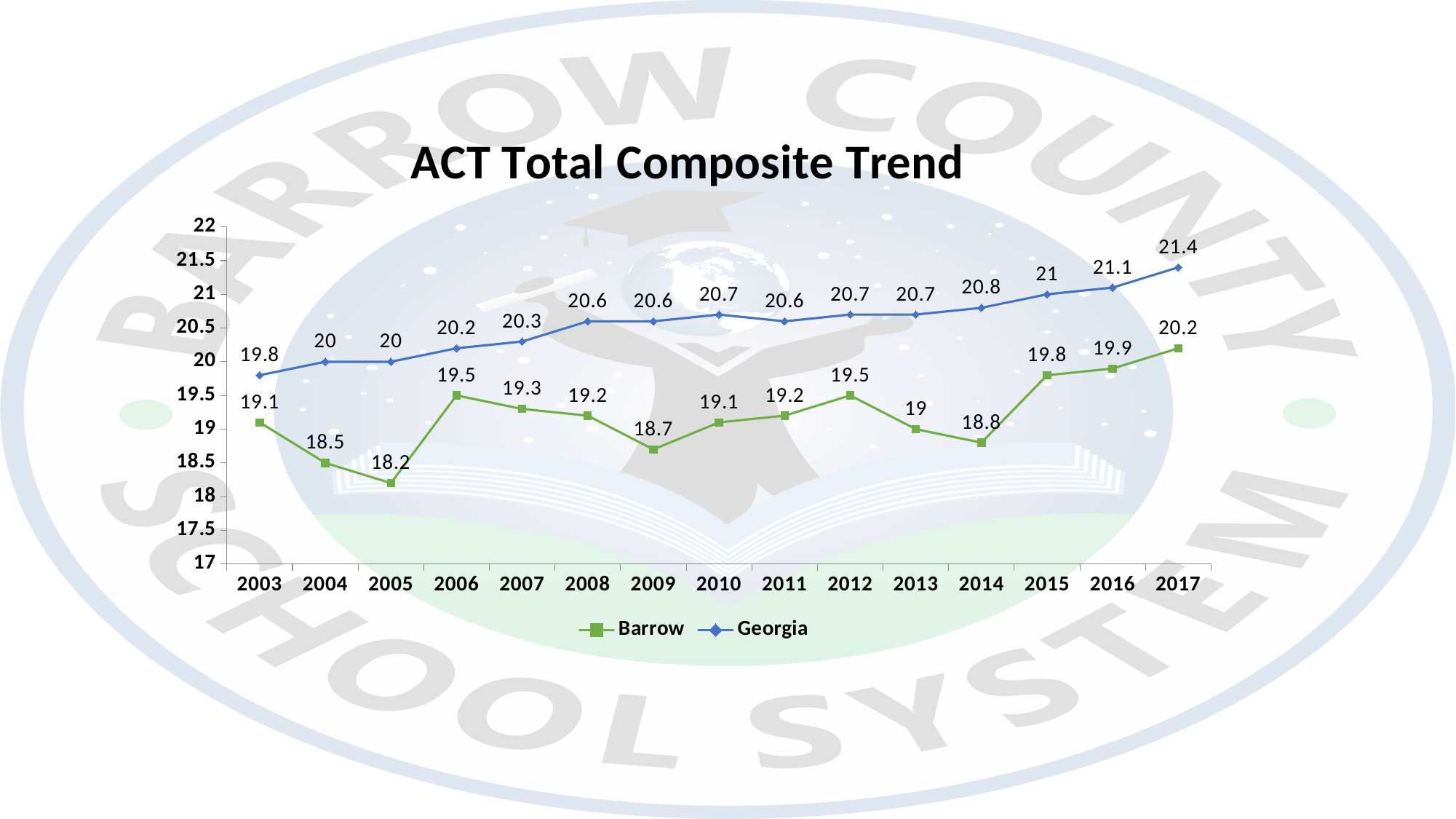
What is the difference between the Barrow values for 2015 and 2014? 1 What kind of chart is this? Line chart What is the title of the chart? ACT Total Composite Trend In which year is the Barrow value lowest? 2005 In which year is the Georgia value highest? 2017 What is the Barrow value for 2005? 18.2 Which series has the larger value in 2009, Barrow or Georgia? Georgia How many years are shown on the x axis? 15 What is the Barrow value for 2012? 19.5 What is the difference between the Georgia and Barrow values in 2017? 1.2 What is the Georgia value for 2017? 21.4 How many series does the legend list? 2